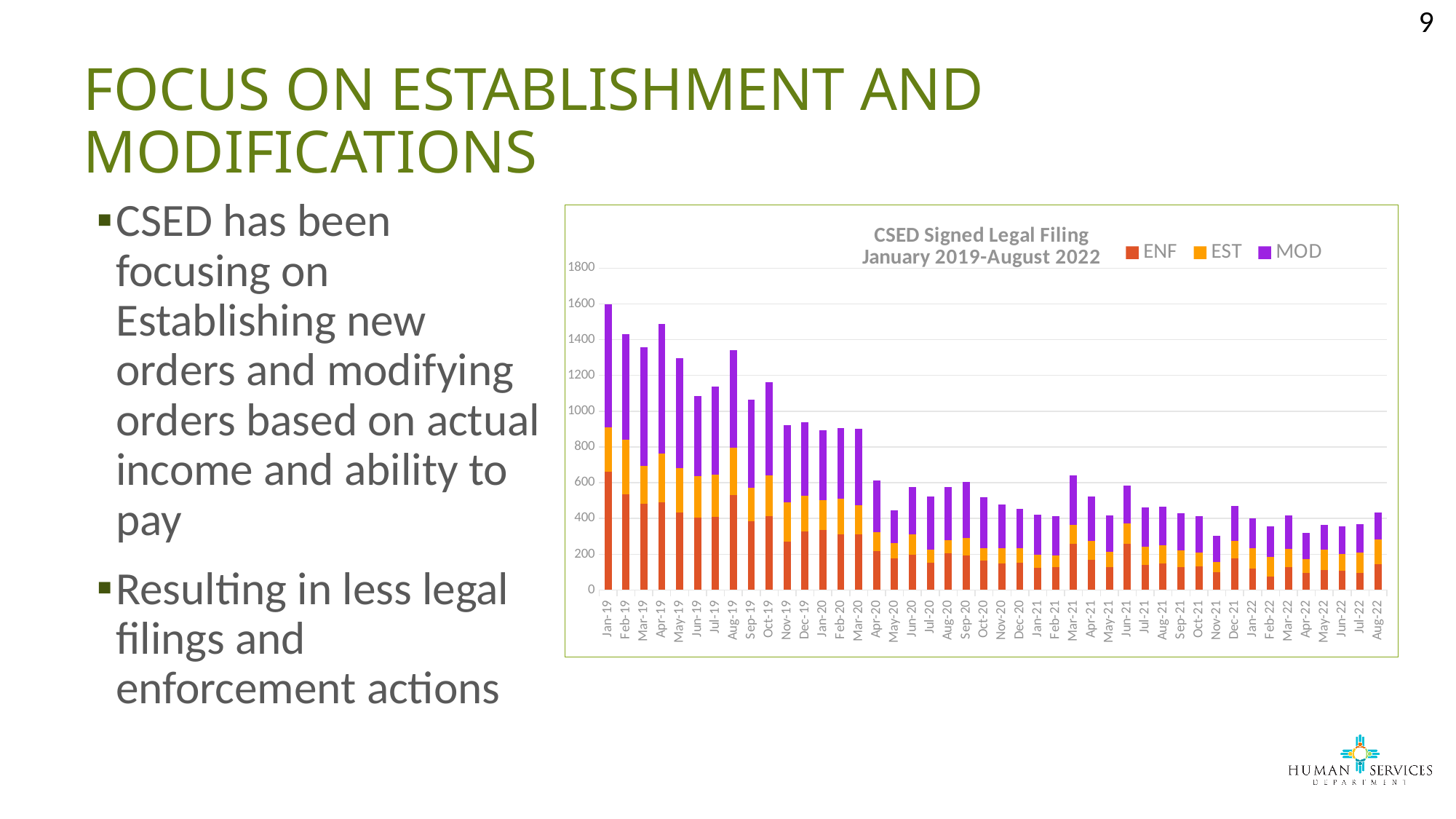
Is the total for Jan-19 greater or less than 1400? greater Is the total for Nov-19 greater or less than 1000? less How many months are plotted along the x axis of the chart? 44 Which month has the highest total signed legal filings? Jan-19 Which has a larger total, Jan-19 or Aug-22? Jan-19 What is the title of the chart? CSED Signed Legal Filing January 2019-August 2022 Is the total for Aug-22 greater or less than 600? less What kind of chart is shown on the slide? Stacked bar chart How many series does the legend of the chart list? 3 What are the series names in the chart's legend? ENF, EST, MOD Do total signed legal filings generally rise or fall from January 2019 to August 2022? fall